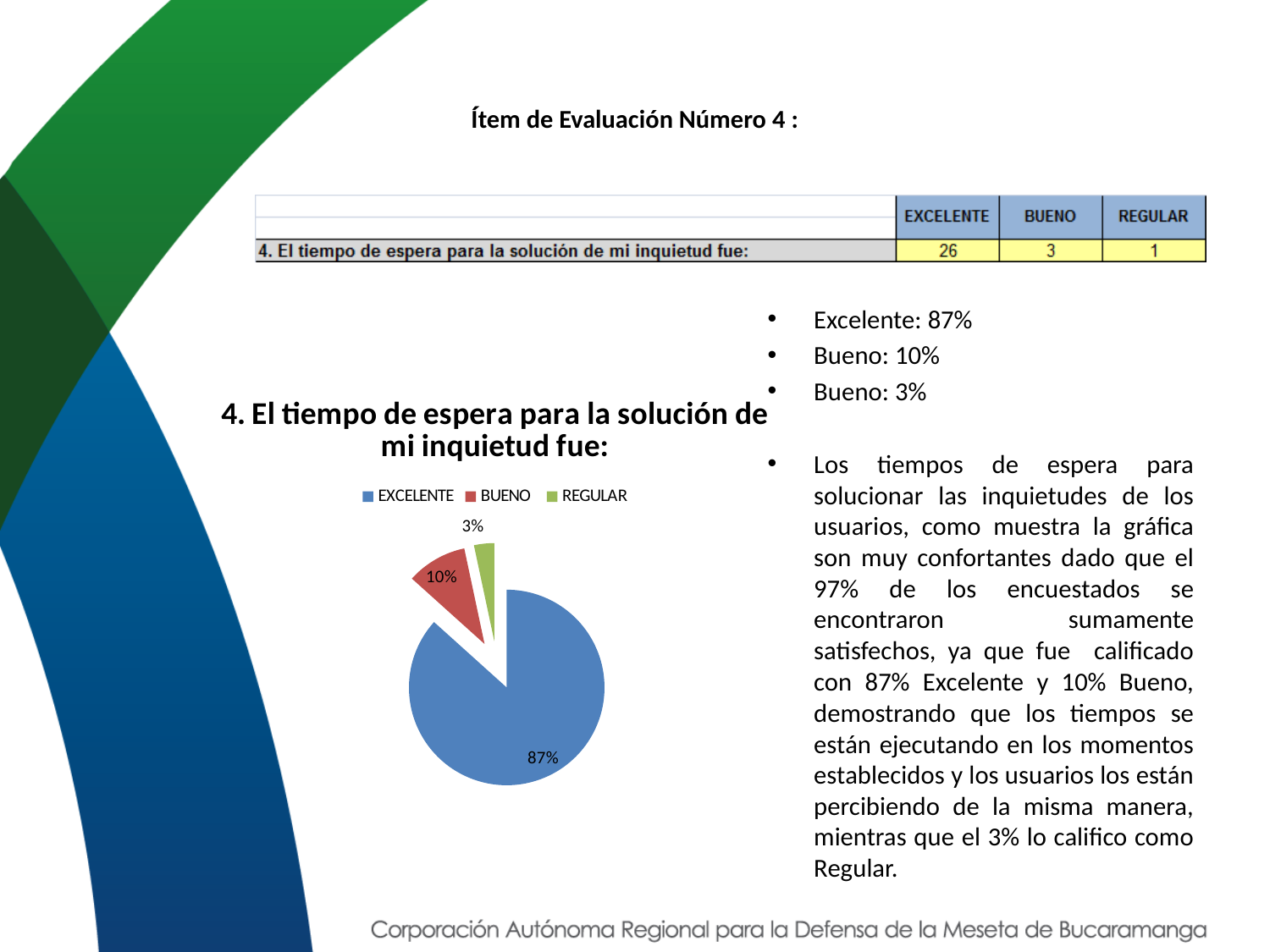
How many slices does the pie chart have? 3 What is the title of the chart? 4. El tiempo de espera para la solución de mi inquietud fue: What is the difference in percentage points between the EXCELENTE and BUENO slices? 77% Which slice is larger, BUENO or REGULAR? BUENO What share of the pie does REGULAR represent? 3% How many entries does the chart legend list? 3 What kind of chart is shown on the slide? pie chart Which category has the largest slice of the pie? EXCELENTE What colour is the EXCELENTE slice in the pie chart? blue What share of the pie does BUENO represent? 10% Which category has the smallest slice of the pie? REGULAR What share of the pie does EXCELENTE represent? 87%